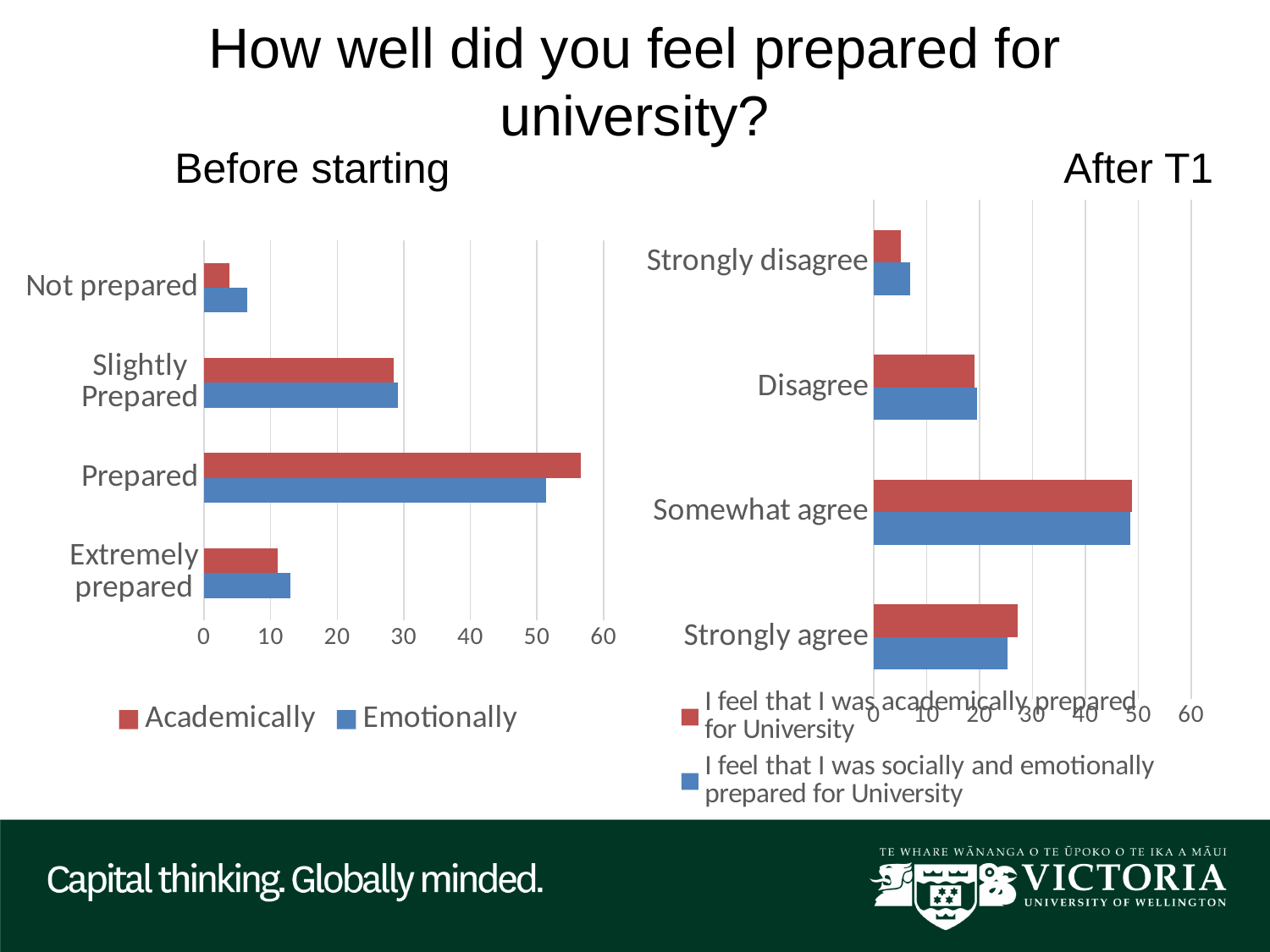
What kind of chart is the "Before starting" chart? bar chart What colour represents the Emotionally series in the "Before starting" chart? blue In the "Before starting" chart, which category has the lowest Emotionally value? Not prepared In the "After T1" chart, which category has the lowest value for "I feel that I was socially and emotionally prepared for University"? Strongly disagree In the "Before starting" chart, is the Academically value for Prepared greater or less than 50? greater In the "Before starting" chart, which category has the highest Academically value? Prepared In the "After T1" chart, which category has the highest value for "I feel that I was academically prepared for University"? Somewhat agree In the "Before starting" chart, for Prepared, which is larger: Academically or Emotionally? Academically How many categories does the "Before starting" chart show? 4 How many series does the legend of the "Before starting" chart list? 2 In the "After T1" chart, is the value for Strongly agree in the "I feel that I was academically prepared for University" series greater or less than 20? greater How many categories does the "After T1" chart show? 4